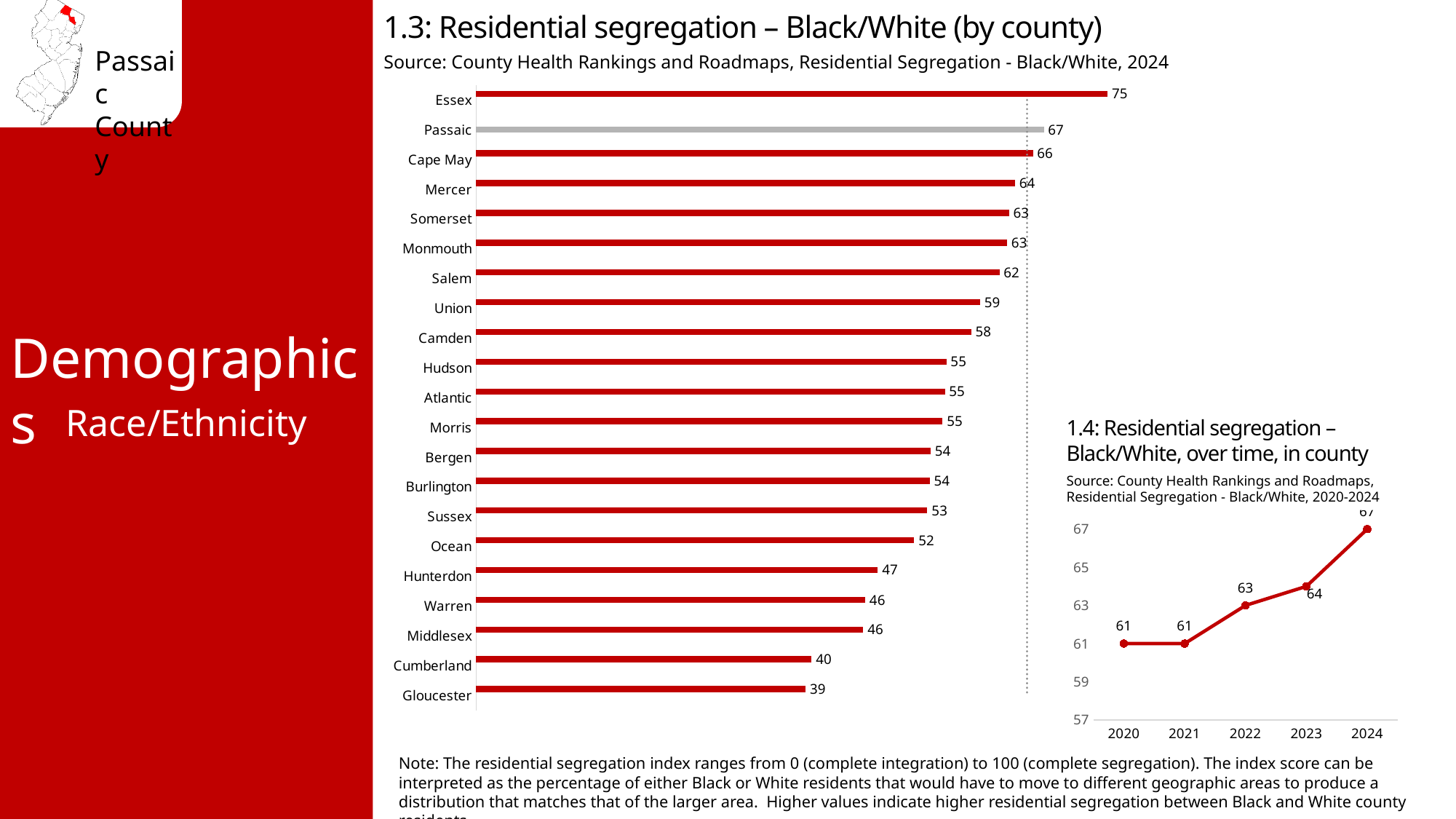
In chart 1.4 (over time), what is the difference between the values for 2022 and 2021? 2 In chart 1.4 (over time), do the values generally rise or fall from 2020 to 2024? Rise What kind of chart is chart 1.3 (Residential segregation – Black/White by county)? Bar chart In chart 1.3 (by county), which has a larger value, Cape May or Hunterdon? Cape May In chart 1.4 (Residential segregation – Black/White over time), what is the value for 2023? 64 In chart 1.3 (by county), what is the difference between the values for Essex and Gloucester? 36 In chart 1.3 (by county), what is the value for Passaic? 67 In chart 1.4 (over time), what is the value for 2020? 61 In chart 1.3 (by county), how many counties are shown? 21 In chart 1.3 (by county), which county has the highest value? Essex In chart 1.3 (by county), which county has the lowest value? Gloucester In chart 1.3 (Residential segregation – Black/White by county), what is the value for Essex? 75